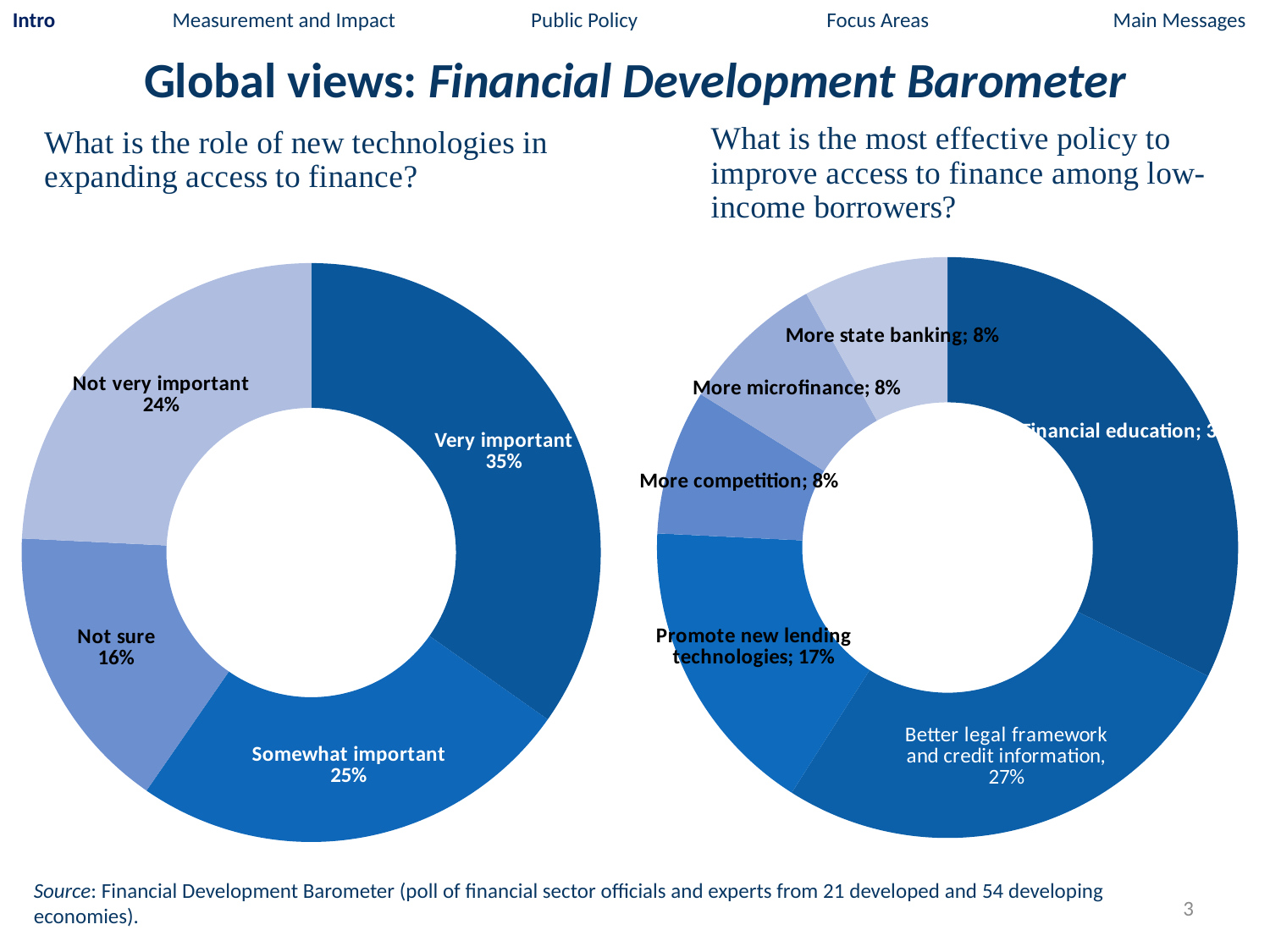
On the right chart (most effective policy), what percentage chose 'Better legal framework and credit information'? 27% On the left chart (role of new technologies), what percentage of respondents said 'Not sure'? 16% What type of chart is used on the left side of the slide? Doughnut (pie) chart On the right chart (most effective policy), how many policy categories are shown? 6 On the left chart (role of new technologies), what is the difference in percentage points between 'Very important' and 'Somewhat important'? 10 On the right chart (most effective policy), what is the difference in percentage points between 'Better legal framework and credit information' and 'Promote new lending technologies'? 10 On the left chart (role of new technologies), how many response categories are shown? 4 On the left chart (role of new technologies), which response has the largest share? Very important On the left chart (role of new technologies), which response has the smallest share? Not sure On the right chart (most effective policy), what percentage chose 'Promote new lending technologies'? 17% On the left chart (role of new technologies), which is larger: 'Not very important' or 'Not sure'? Not very important On the left chart (role of new technologies), what percentage of respondents said 'Very important'? 35%